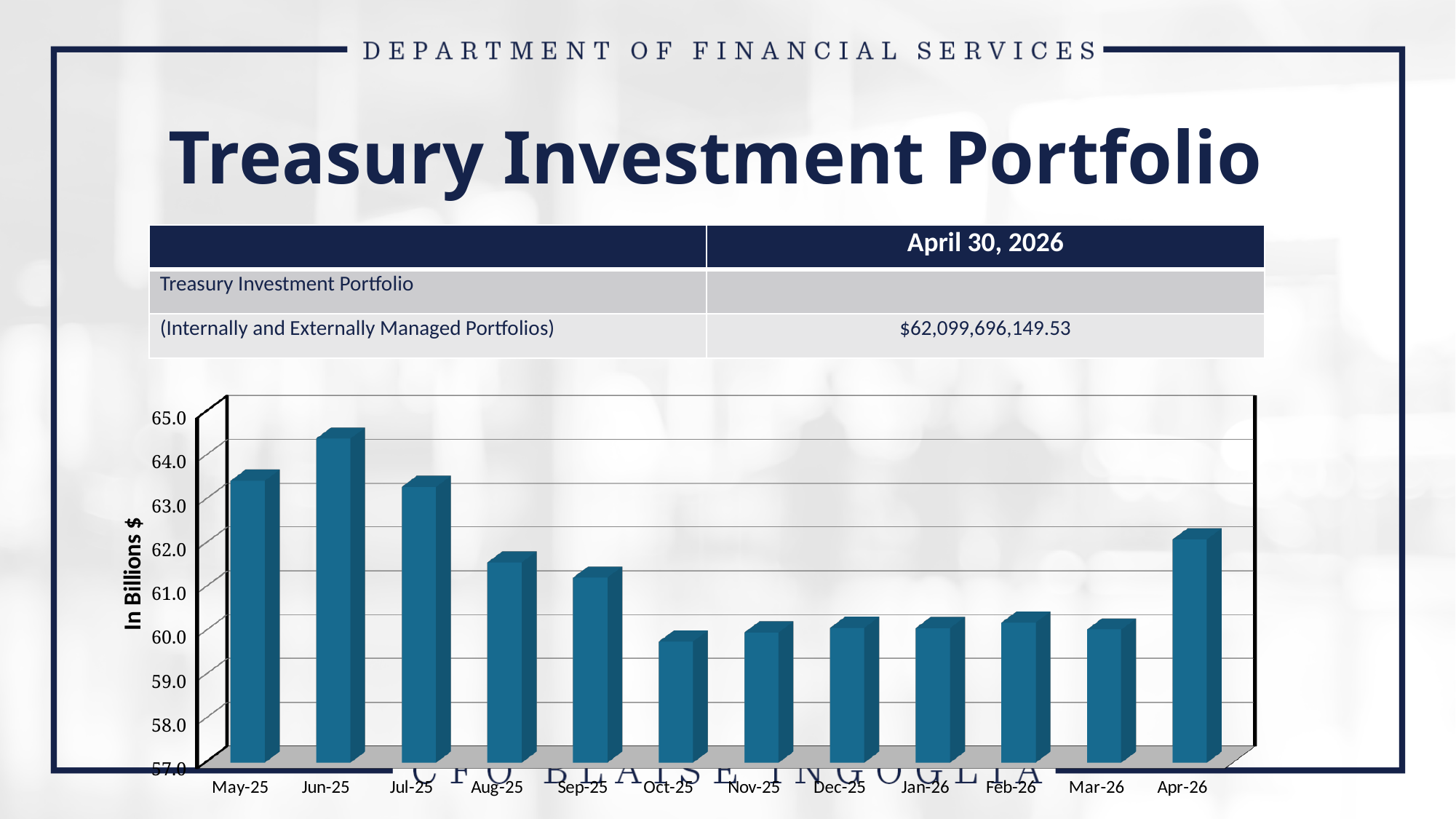
Which is larger, the value for May-25 or the value for Apr-26? May-25 Is the value for Apr-26 greater or less than 61.0? greater Which month has the highest value on the chart? Jun-25 How many months are plotted on the chart? 12 Is the value for Sep-25 greater or less than 62.0? less Do the values rise or fall from Jun-25 to Oct-25? fall What kind of chart is shown on the slide? bar chart Is the value for Oct-25 greater or less than 60.0? less Which month has the lowest value on the chart? Oct-25 Which is larger, the value for Jun-25 or the value for Jul-25? Jun-25 What is the label on the vertical axis of the chart? In Billions $